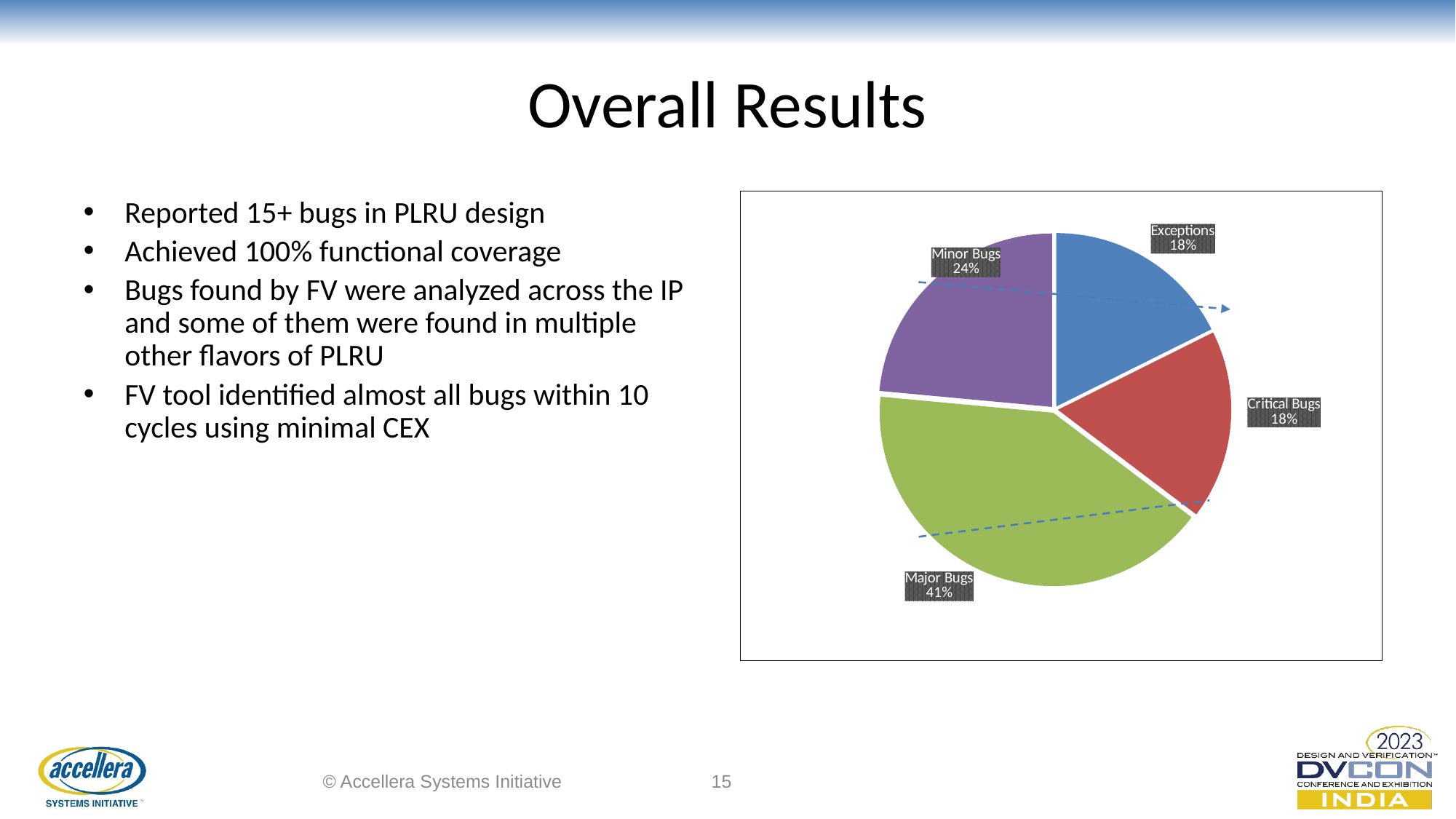
What colour is the Exceptions slice? blue How many slices does the pie chart have? 4 Which is larger, the Minor Bugs slice or the Critical Bugs slice? Minor Bugs What colour is the Major Bugs slice? green What is the difference in percentage points between Minor Bugs and Exceptions? 6 What share of the pie is Exceptions? 18% What share of the pie is Minor Bugs? 24% What is the difference in percentage points between Major Bugs and Minor Bugs? 17 What share of the pie is Critical Bugs? 18% Which category has the largest slice of the pie? Major Bugs What kind of chart is shown on the slide? pie chart